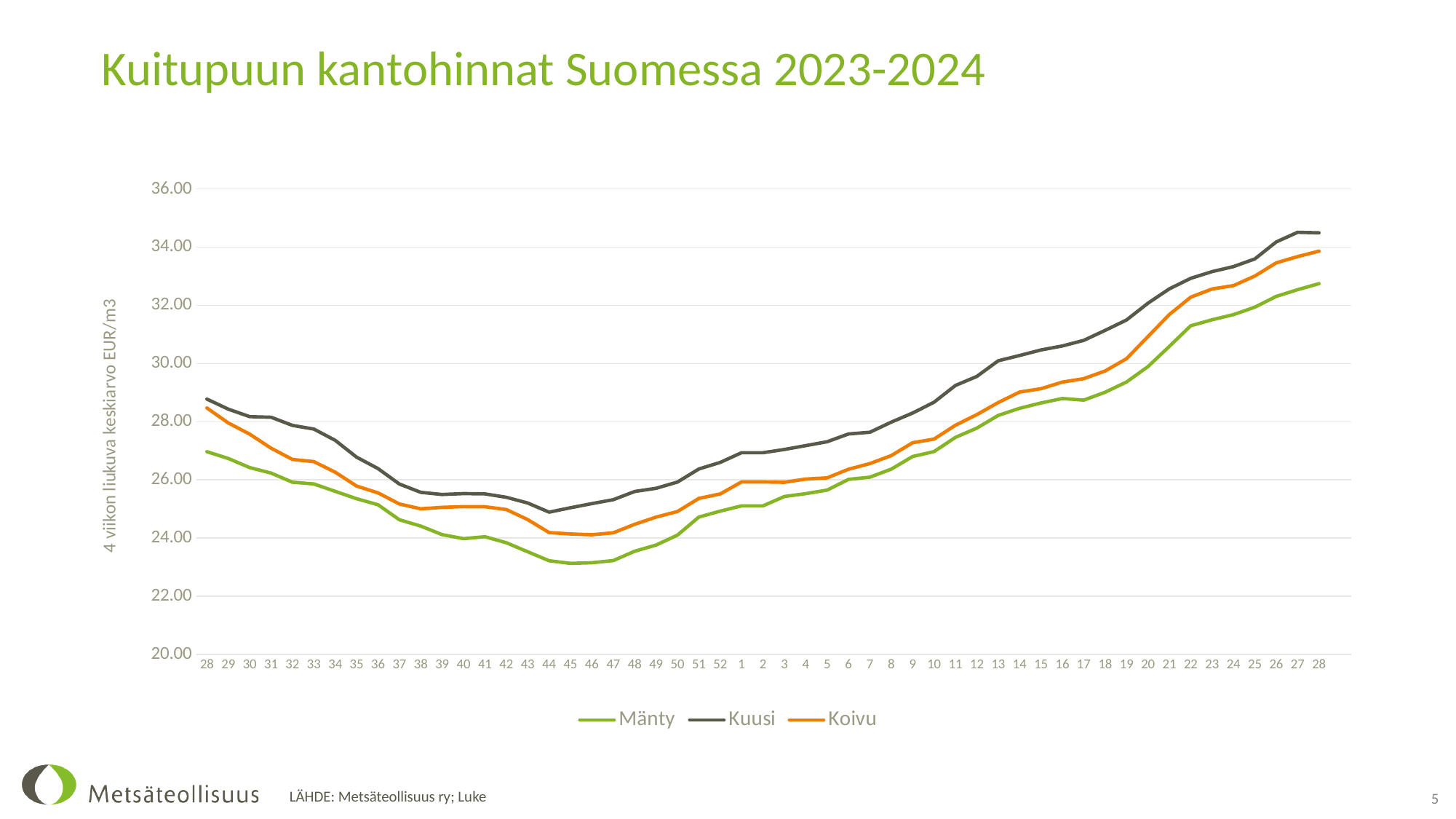
What are the series names listed in the legend? Mänty, Kuusi, Koivu At the last week (28), which is higher, Kuusi or Mänty? Kuusi How many series does the legend list? 3 What kind of chart is shown on the slide? line chart Which series has the highest values across the whole chart? Kuusi Which series has the lowest values across the whole chart? Mänty Is the value for Kuusi at the last week (28) greater or less than 34.00? greater Do the values rise or fall from week 45 to the last week (28)? rise Is the value for Mänty at week 45 greater or less than 24.00? less Is the value for Kuusi at week 44 greater or less than 26.00? less What is the title of the chart? Kuitupuun kantohinnat Suomessa 2023-2024